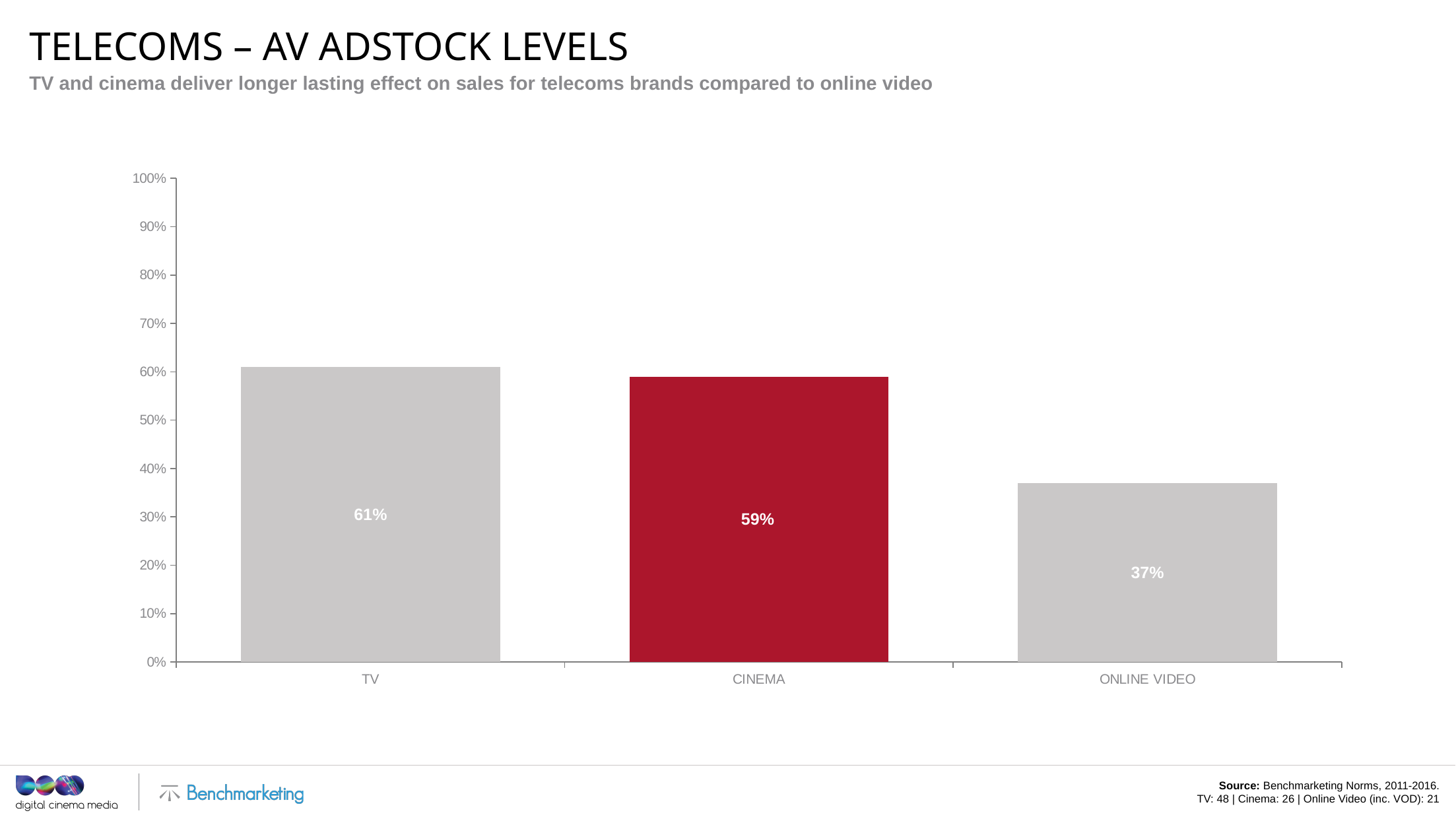
Which category has the highest adstock level? TV What is the AV adstock level for Online Video? 37% What is the AV adstock level for TV? 61% Which category has the lowest adstock level? Online Video What is the difference between the adstock levels for TV and Online Video? 24% Which has a higher adstock level, Cinema or Online Video? Cinema What is the difference between the adstock levels for Cinema and Online Video? 22% What is the AV adstock level for Cinema? 59% How many categories are shown in the chart? 3 Is the value for Online Video greater or less than 40%? less What kind of chart is shown on the slide? Bar chart Which bar is coloured red rather than grey? Cinema